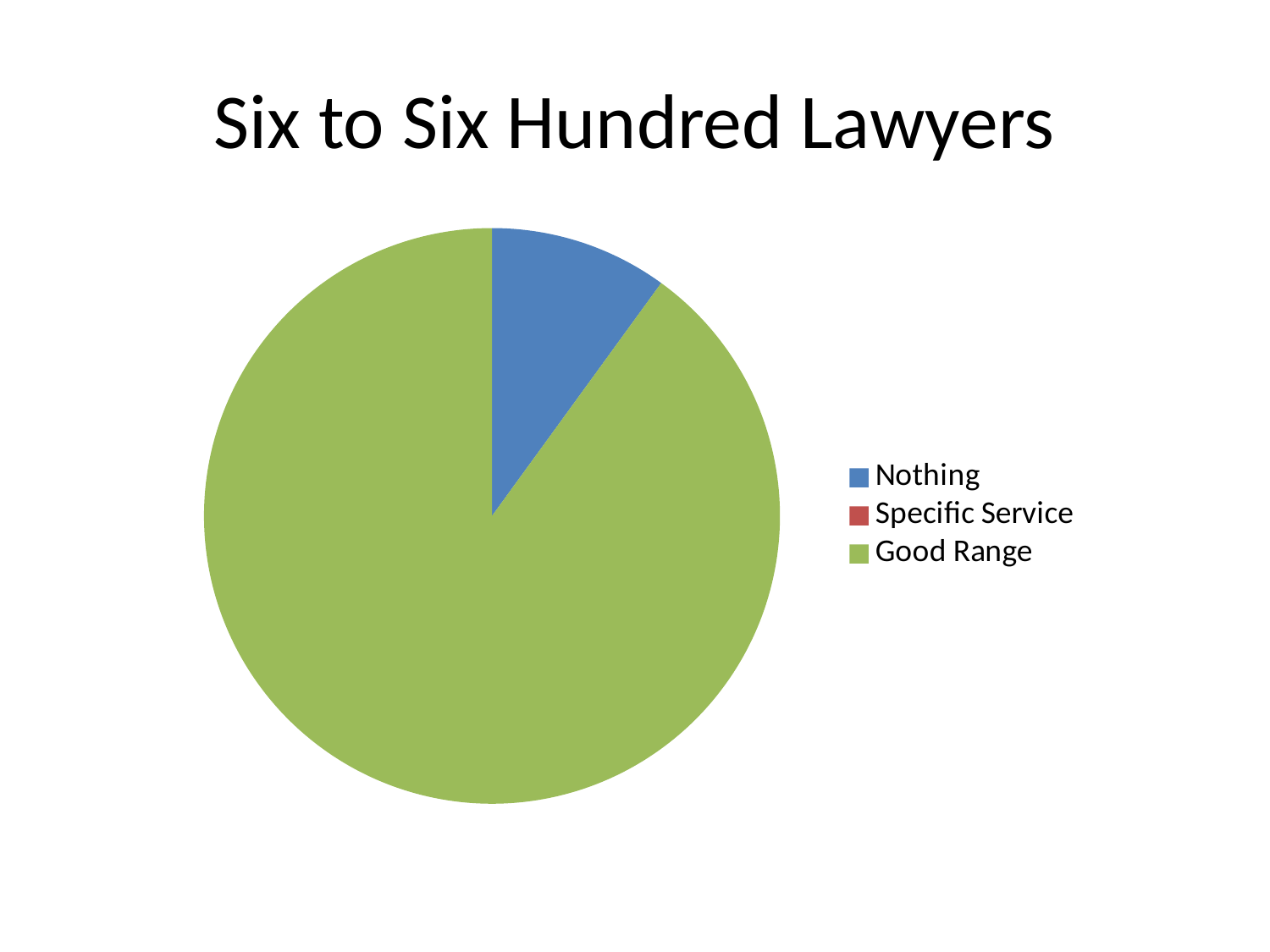
What kind of chart is shown on the slide? pie chart How many categories does the legend of the pie chart list? 3 Which category has the smallest slice of the pie? Specific Service Which slice is larger, Nothing or Specific Service? Nothing What is the title of the slide containing the pie chart? Six to Six Hundred Lawyers What colour is the Good Range slice of the pie chart? green Which slice is larger, Nothing or Good Range? Good Range Which category has the largest slice of the pie? Good Range